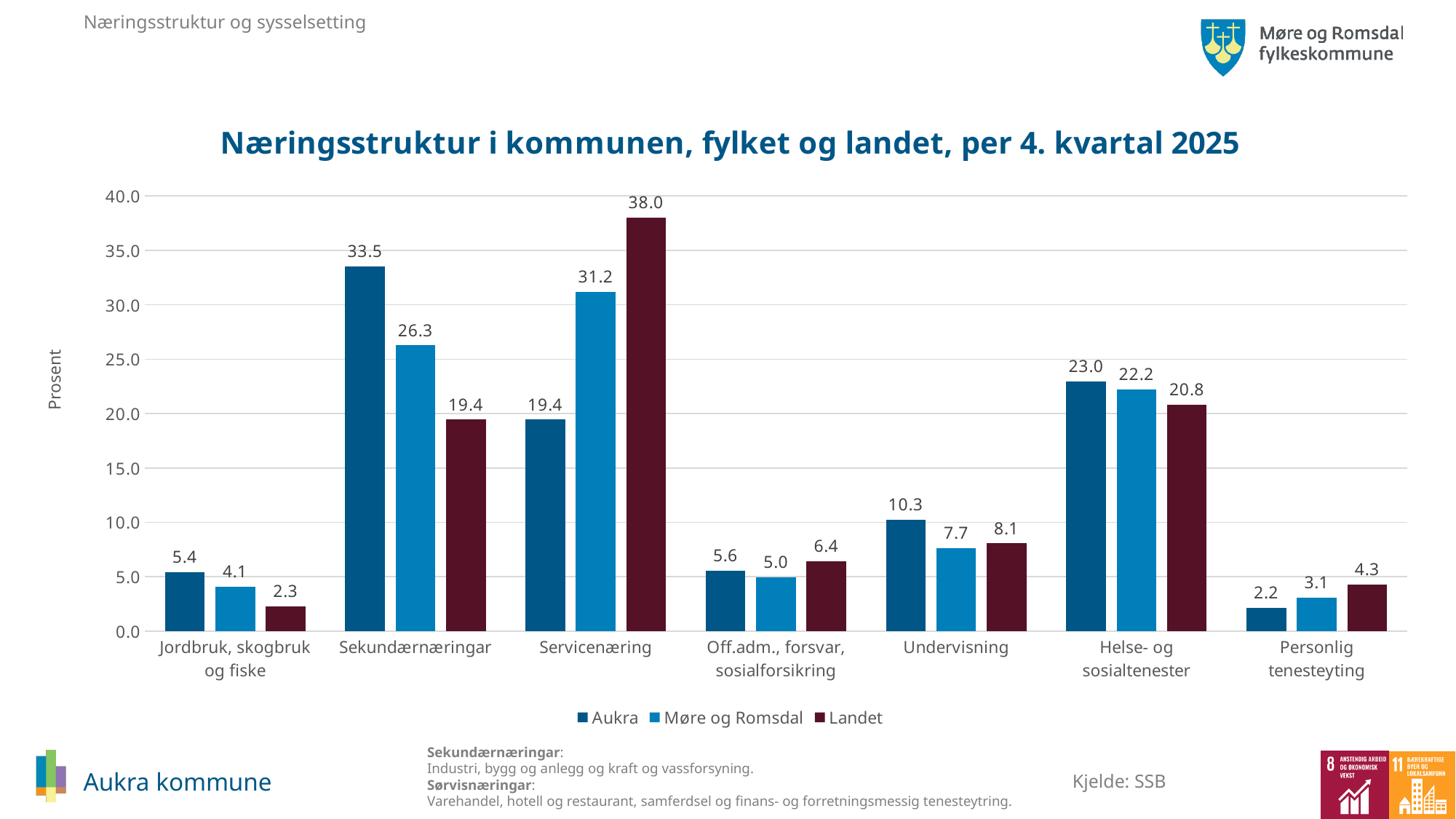
What is the label of the y axis? Prosent How many series does the legend list? 3 Which category has the highest value for Aukra? Sekundærnæringar Is the value for Møre og Romsdal in Sekundærnæringar greater or less than 25.0? greater How many categories are shown on the x axis? 7 What is the value for Landet in Servicenæring? 38.0 What is the value for Aukra in Sekundærnæringar? 33.5 What is the difference between Landet and Aukra in Servicenæring? 18.6 What kind of chart is shown? Bar chart What is the value for Møre og Romsdal in Helse- og sosialtenester? 22.2 Which is larger in Undervisning: Aukra or Møre og Romsdal? Aukra Which category has the lowest value for Landet? Jordbruk, skogbruk og fiske